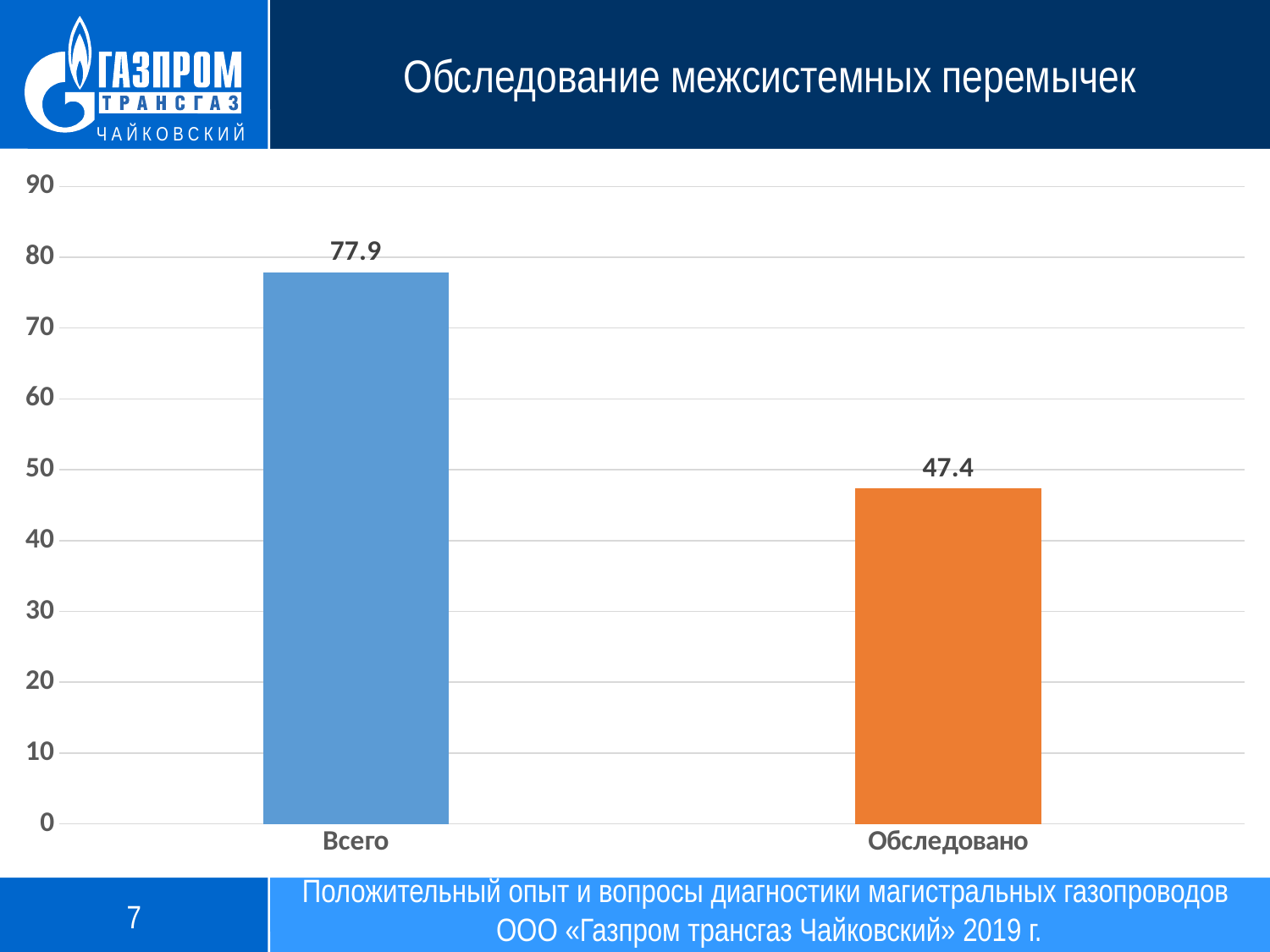
How many categories are shown on the chart? 2 Is the value for Всего greater or less than 70? greater Which category has the highest value? Всего What kind of chart is shown on the slide? bar chart What is the difference between the values for Всего and Обследовано? 30.5 What is the value for Всего? 77.9 What is the title of the slide containing the chart? Обследование межсистемных перемычек Is the value for Обследовано greater or less than 50? less Which is larger, the value for Всего or the value for Обследовано? Всего What is the value for Обследовано? 47.4 Which category has the lowest value? Обследовано What colour is the bar for Обследовано? orange